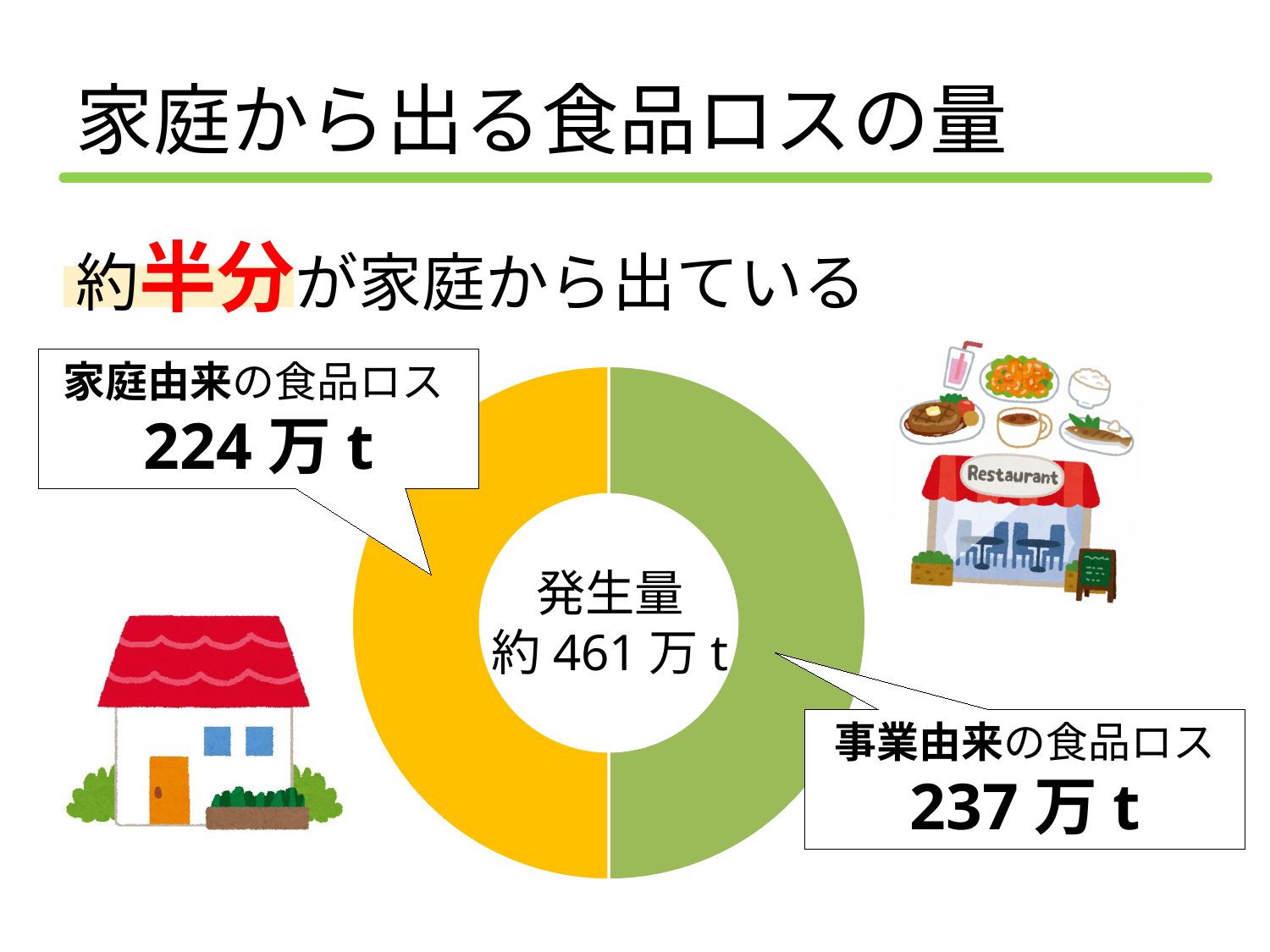
グラフの中央に示されている食品ロスの発生量はいくらですか？ 約461万t 家庭由来の食品ロスを示す部分は何色ですか？ 黄色 家庭由来の食品ロスの量はいくらですか？ 224万t 家庭由来と事業由来のうち、食品ロスの量が多いのはどちらですか？ 事業由来の食品ロス 事業由来の食品ロスは家庭由来の食品ロスより何万t多いですか？ 13万t このスライドのタイトルは何ですか？ 家庭から出る食品ロスの量 このグラフはいくつの区分に分かれていますか？ 2 事業由来の食品ロスの量はいくらですか？ 237万t 家庭由来の食品ロスは事業由来の食品ロスより多いですか、少ないですか？ 少ない 家庭由来と事業由来の食品ロスを合計すると何万tになりますか？ 461万t このスライドのグラフはどの種類のグラフですか？ 円グラフ（ドーナツグラフ） 家庭由来と事業由来のうち、食品ロスの量が少ないのはどちらですか？ 家庭由来の食品ロス